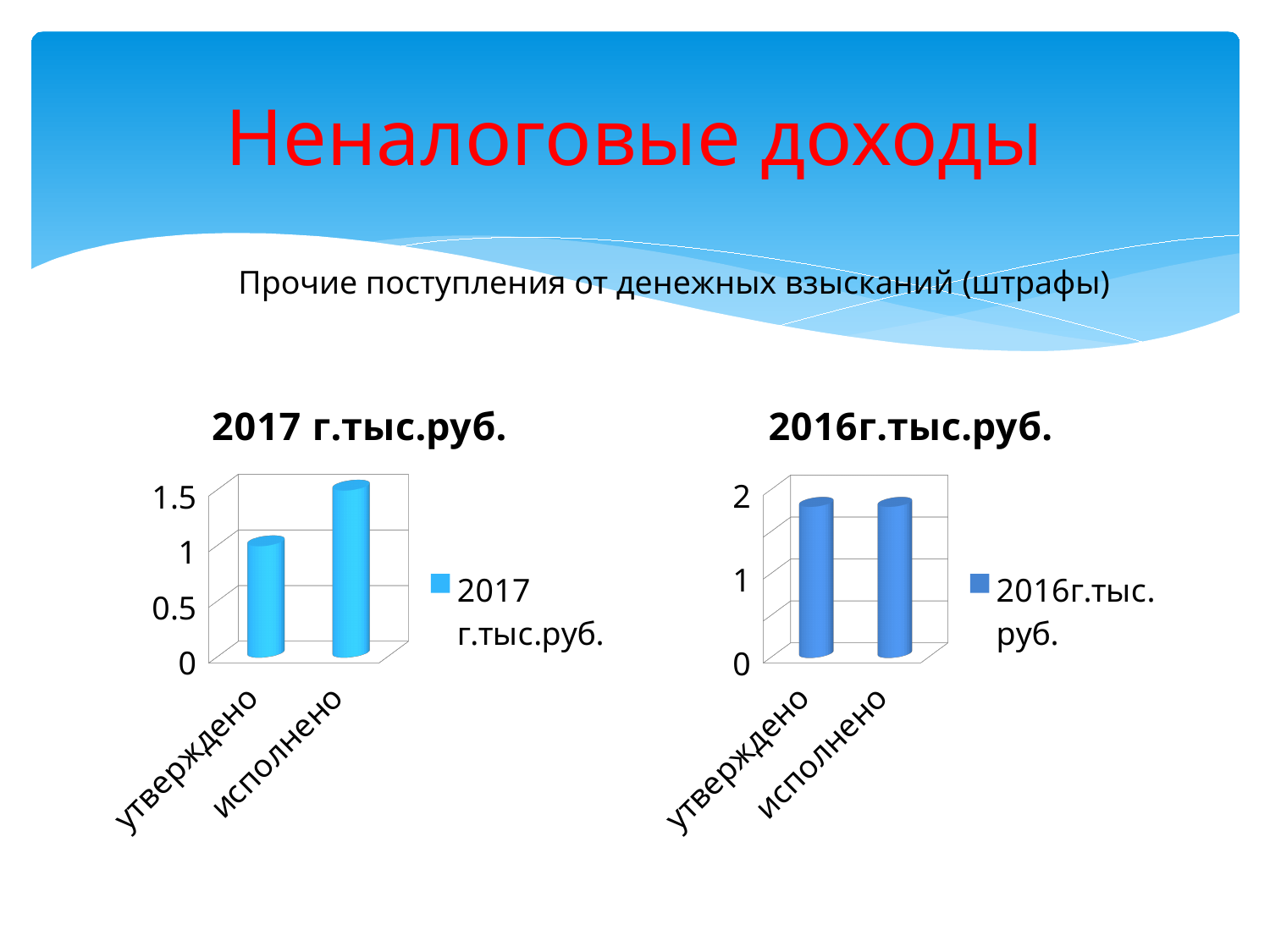
What is the title of the chart on the left side of the slide? 2017 г.тыс.руб. In the chart titled "2016г.тыс.руб.", is the value for утверждено greater or less than 1? greater In the chart titled "2017 г.тыс.руб.", is the value for исполнено greater or less than 1? greater How many categories are shown in the chart titled "2017 г.тыс.руб."? 2 In the chart titled "2017 г.тыс.руб.", do the values rise or fall from утверждено to исполнено? Rise In the chart titled "2017 г.тыс.руб.", which category has the lowest value? утверждено In the chart titled "2016г.тыс.руб.", is the value for исполнено greater or less than 2? less In the chart titled "2017 г.тыс.руб.", which is larger: утверждено or исполнено? исполнено What kind of chart is the chart titled "2016г.тыс.руб."? Bar chart How many series does the legend list in the chart titled "2016г.тыс.руб."? 1 In the chart titled "2017 г.тыс.руб.", which category has the highest value? исполнено